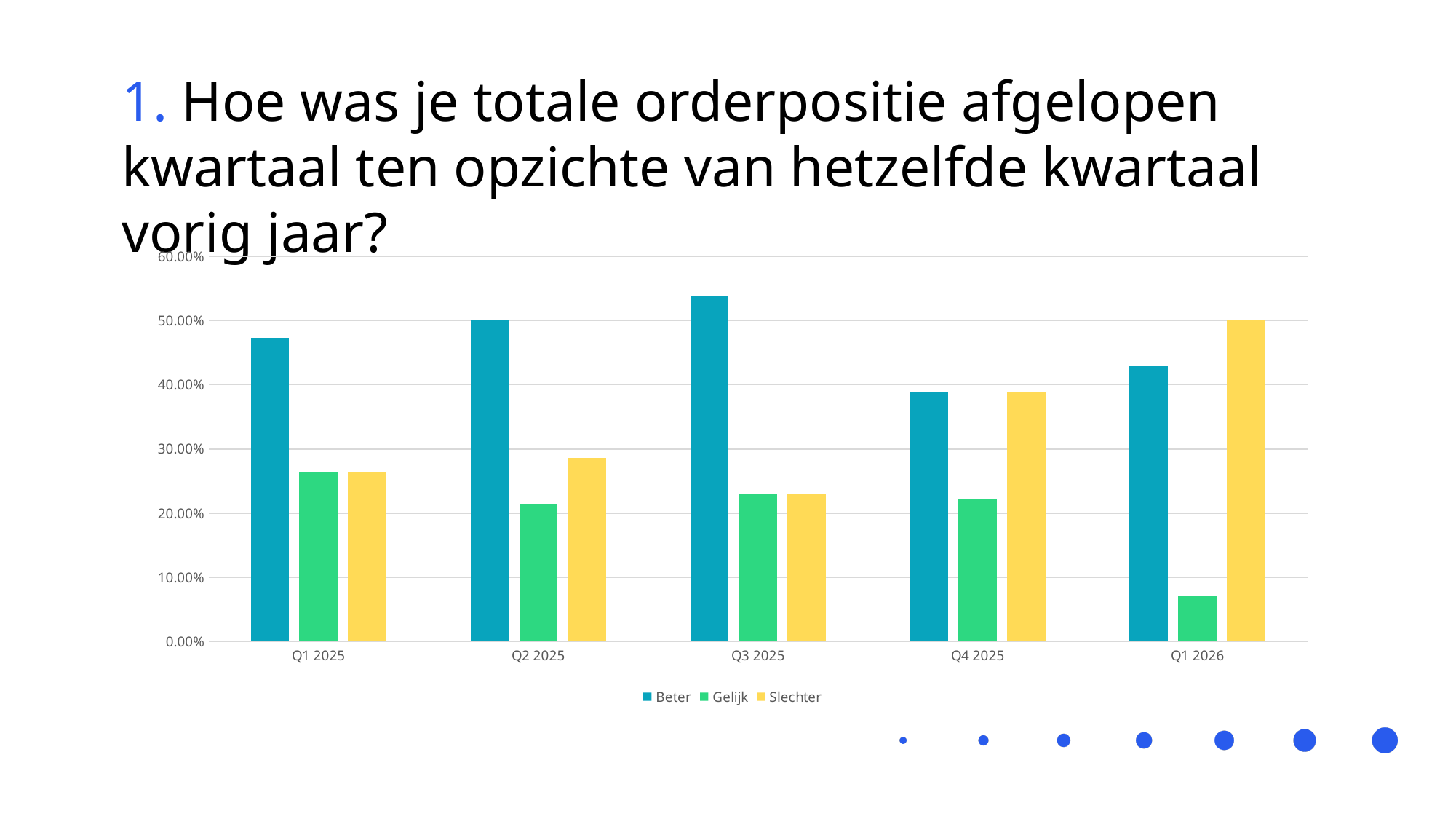
In which quarter is the Gelijk value lowest? Q1 2026 Is the Gelijk value for Q1 2026 greater or less than 10.00%? less How many series does the legend list? 3 Which series are listed in the legend? Beter, Gelijk, Slechter In Q1 2026, which is larger: Beter or Slechter? Slechter In which quarter is the Beter value highest? Q3 2025 What kind of chart is shown on the slide? bar chart In which quarter is the Slechter value highest? Q1 2026 Is the Beter value for Q3 2025 greater or less than 50.00%? greater How many quarters are shown on the x axis? 5 Is the Slechter value for Q2 2025 greater or less than 30.00%? less In Q1 2025, which is larger: Beter or Gelijk? Beter